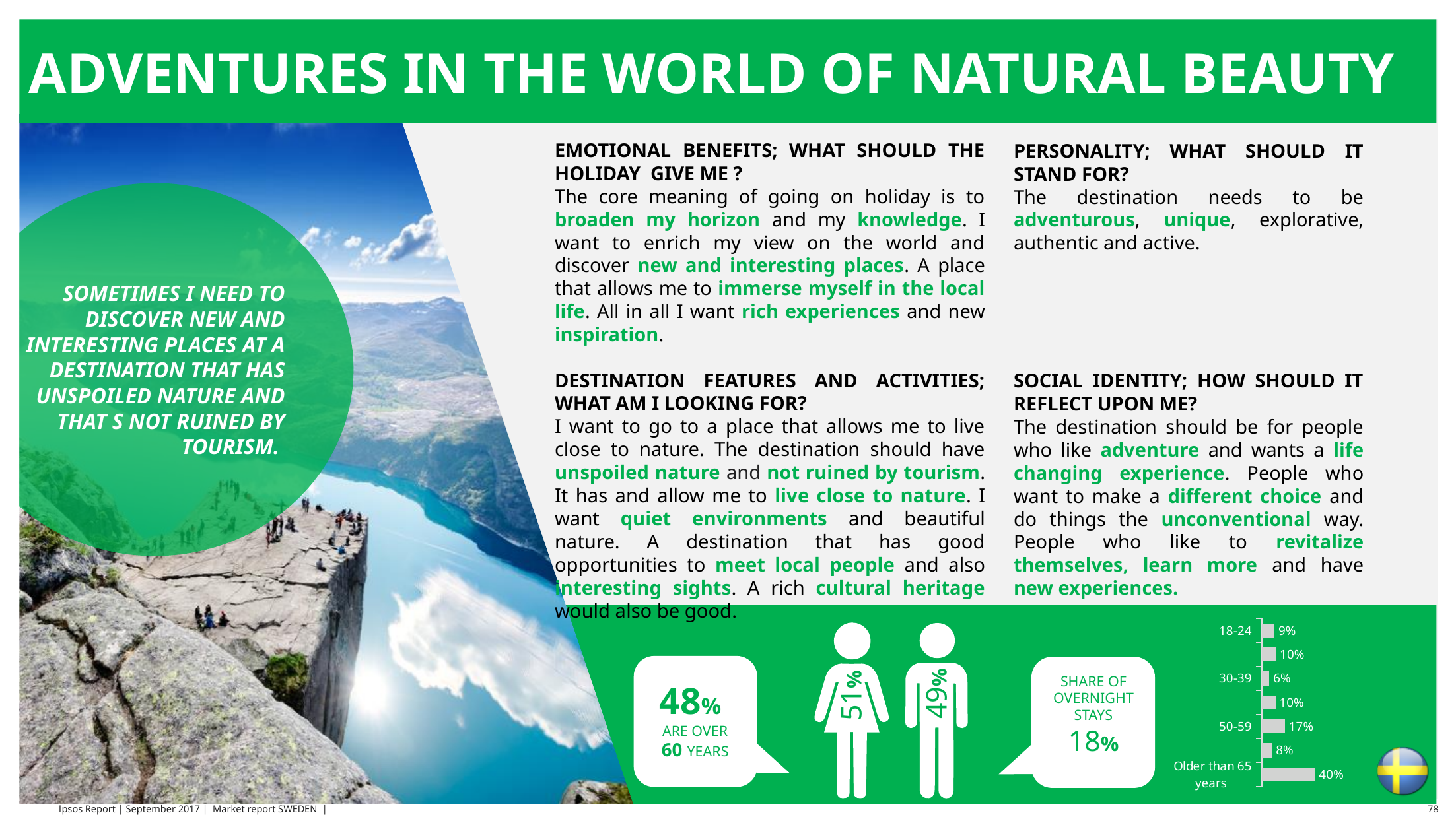
In the age-group bar chart, which age group has the lowest value? 30-39 What colour are the bars in the age-group bar chart? grey In the age-group bar chart, which age group has the highest value? Older than 65 years In the age-group bar chart, what is the value for the 30-39 group? 6% In the age-group bar chart, what is the value for the 'Older than 65 years' group? 40% In the age-group bar chart, what is the difference between the 'Older than 65 years' value and the 50-59 value? 23% In the age-group bar chart, what is the difference between the 18-24 value and the 30-39 value? 3% What kind of chart is shown in the bottom right of the slide? bar chart In the age-group bar chart, what is the value for the 50-59 group? 17% In the age-group bar chart, which is larger: the value for 50-59 or the value for 18-24? 50-59 In the age-group bar chart, what is the value for the 18-24 group? 9% How many bars are plotted in the age-group bar chart? 7